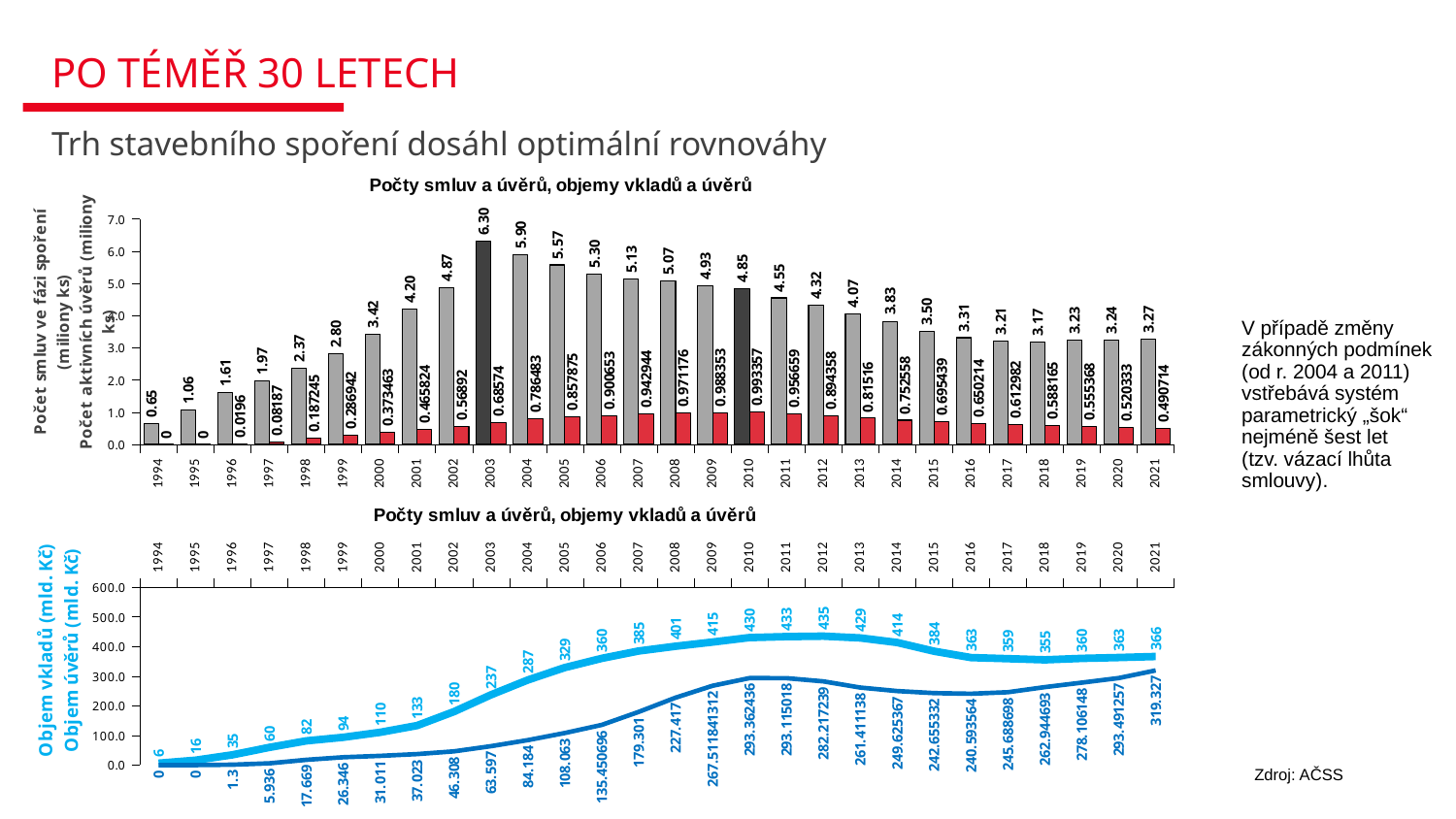
In the top bar chart, what is the difference between the grey bar values for 2003 and 2021? 3.03 How many years are shown on the x axis of the bottom line chart? 28 In the top bar chart, what is the value of the grey bar for 2003? 6.30 In the top bar chart, which year has the highest grey bar? 2003 In the bottom line chart, which is larger in 2008: the light blue line value or the dark blue line value? light blue line (401) In the bottom line chart, what is the value of the light blue line for 2012? 435 In the top bar chart, what is the value of the red bar for 2010? 0.993357 In the top bar chart, is the grey bar for 2001 greater or less than 4.0? greater What type of chart is the top chart on the slide? bar chart In the top bar chart, which year has the lowest grey bar? 1994 In the bottom line chart, does the light blue line rise or fall between 1994 and 2012? rise In the bottom line chart, what is the value of the dark blue line for 2021? 319.327